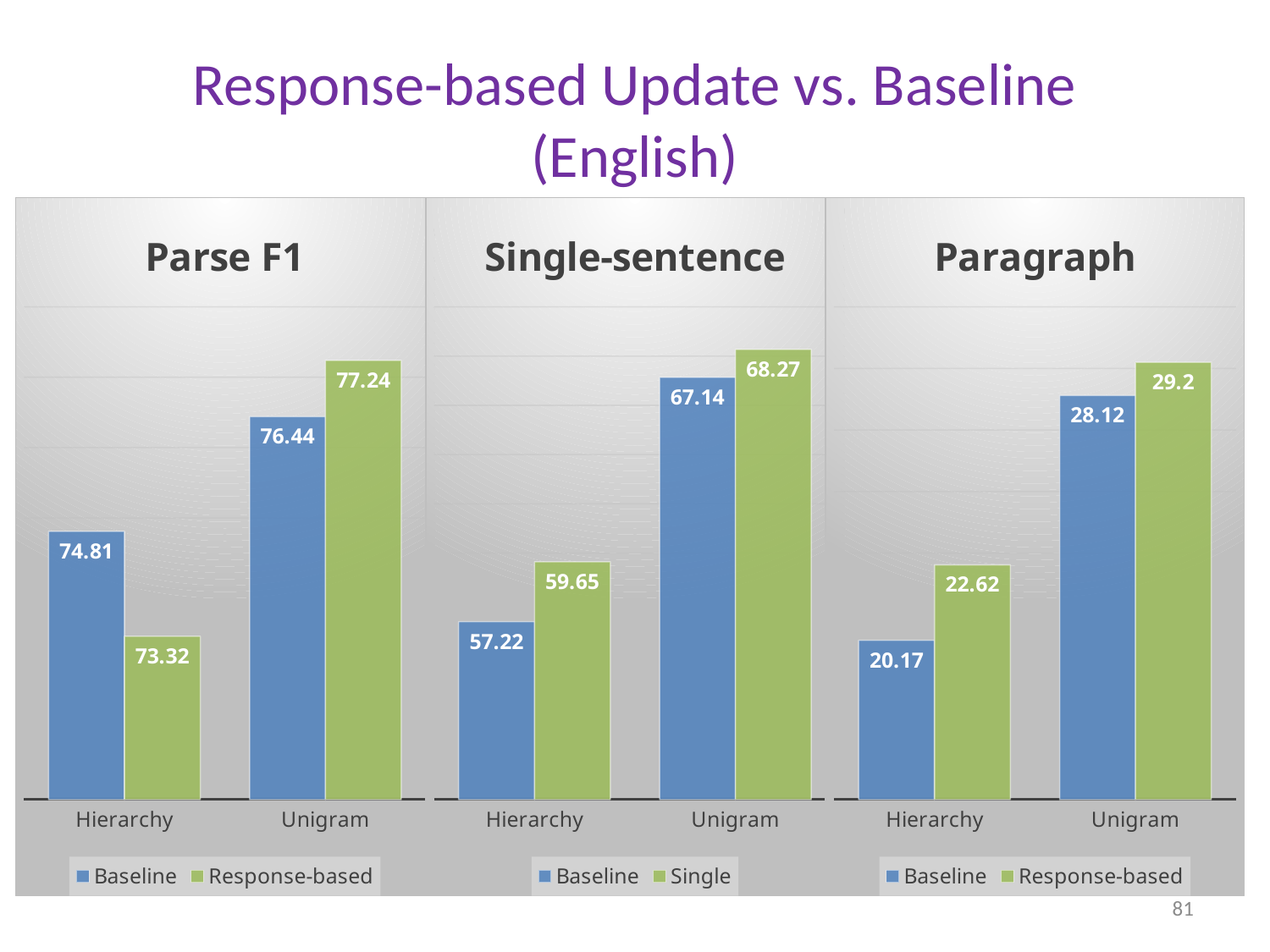
In the Paragraph chart, what is the Response-based value for Hierarchy? 22.62 In the Paragraph chart, what is the difference between the Response-based and Baseline values for Unigram? 1.08 In the Single-sentence chart, which bar is the highest? Single for Unigram In the Paragraph chart, which bar is the lowest? Baseline for Hierarchy In the Single-sentence chart, what is the Baseline value for Unigram? 67.14 In the Single-sentence chart, what is the difference between the Single and Baseline values for Hierarchy? 2.43 How many categories are shown on the x axis of the Paragraph chart? 2 In the Parse F1 chart, what is the Baseline value for Hierarchy? 74.81 What kind of chart is the Single-sentence chart? Bar chart How many series does the legend of the Parse F1 chart list? 2 In the Parse F1 chart, which is larger for Hierarchy: Baseline or Response-based? Baseline In the Parse F1 chart, what is the Response-based value for Unigram? 77.24